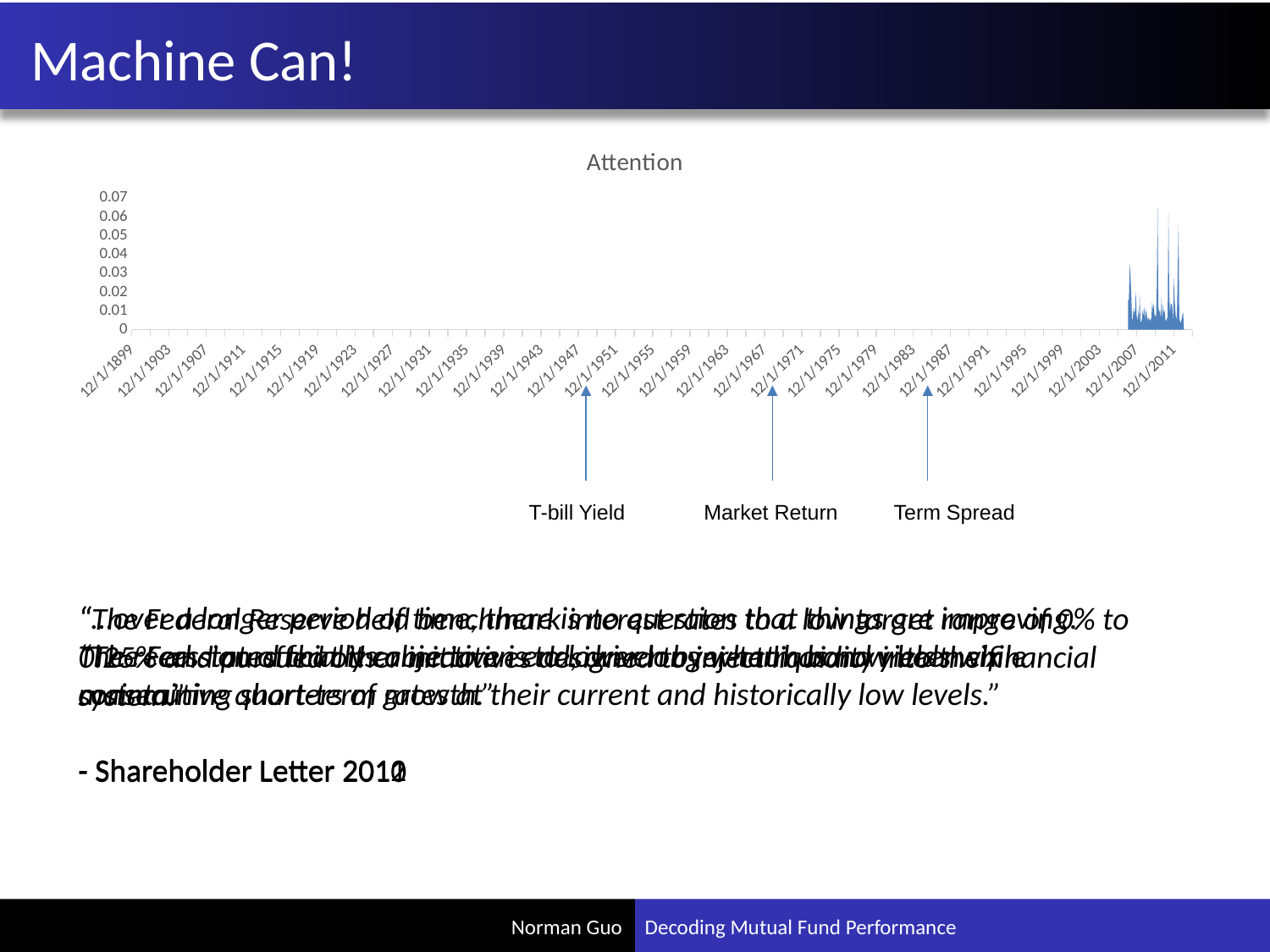
What is the first date label on the chart's horizontal axis? 12/1/1899 In which part of the time axis do the Attention values rise sharply: the beginning, the middle, or the end? the end Which arrow label is positioned furthest to the right below the chart? Term Spread What are the three labels attached to the arrows below the chart, from left to right? T-bill Yield, Market Return, Term Spread What is the last date label on the chart's horizontal axis? 12/1/2011 What is the title of the chart on the slide? Attention Is the peak value of the Attention series greater or less than 0.05? greater How many labelled arrows point to the chart's horizontal axis? 3 What is the highest value shown on the chart's vertical axis? 0.07